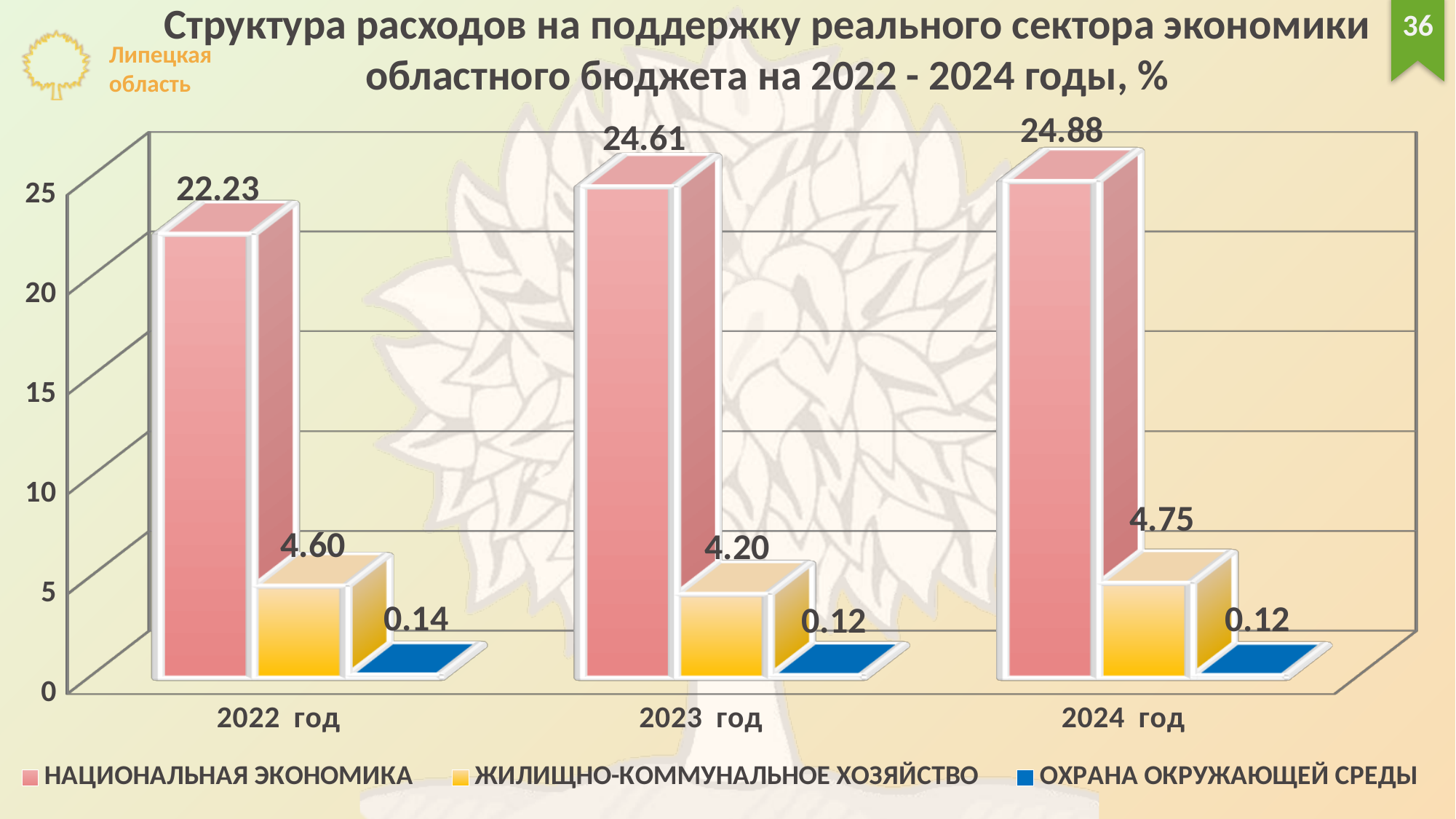
In which year is the value for НАЦИОНАЛЬНАЯ ЭКОНОМИКА highest? 2024 год How many years are shown on the x axis? 3 What is the value for ОХРАНА ОКРУЖАЮЩЕЙ СРЕДЫ in 2024 год? 0.12 How many series does the legend list? 3 Does the value for НАЦИОНАЛЬНАЯ ЭКОНОМИКА rise or fall from 2022 год to 2024 год? rise In which year is the value for ЖИЛИЩНО-КОММУНАЛЬНОЕ ХОЗЯЙСТВО lowest? 2023 год Is the value for НАЦИОНАЛЬНАЯ ЭКОНОМИКА in 2023 год greater or less than 20? greater What is the difference between the НАЦИОНАЛЬНАЯ ЭКОНОМИКА values for 2024 год and 2022 год? 2.65 Which is larger: ЖИЛИЩНО-КОММУНАЛЬНОЕ ХОЗЯЙСТВО in 2022 год or in 2024 год? 2024 год What kind of chart is shown on the slide? bar chart What is the value for НАЦИОНАЛЬНАЯ ЭКОНОМИКА in 2022 год? 22.23 What is the value for ЖИЛИЩНО-КОММУНАЛЬНОЕ ХОЗЯЙСТВО in 2023 год? 4.20